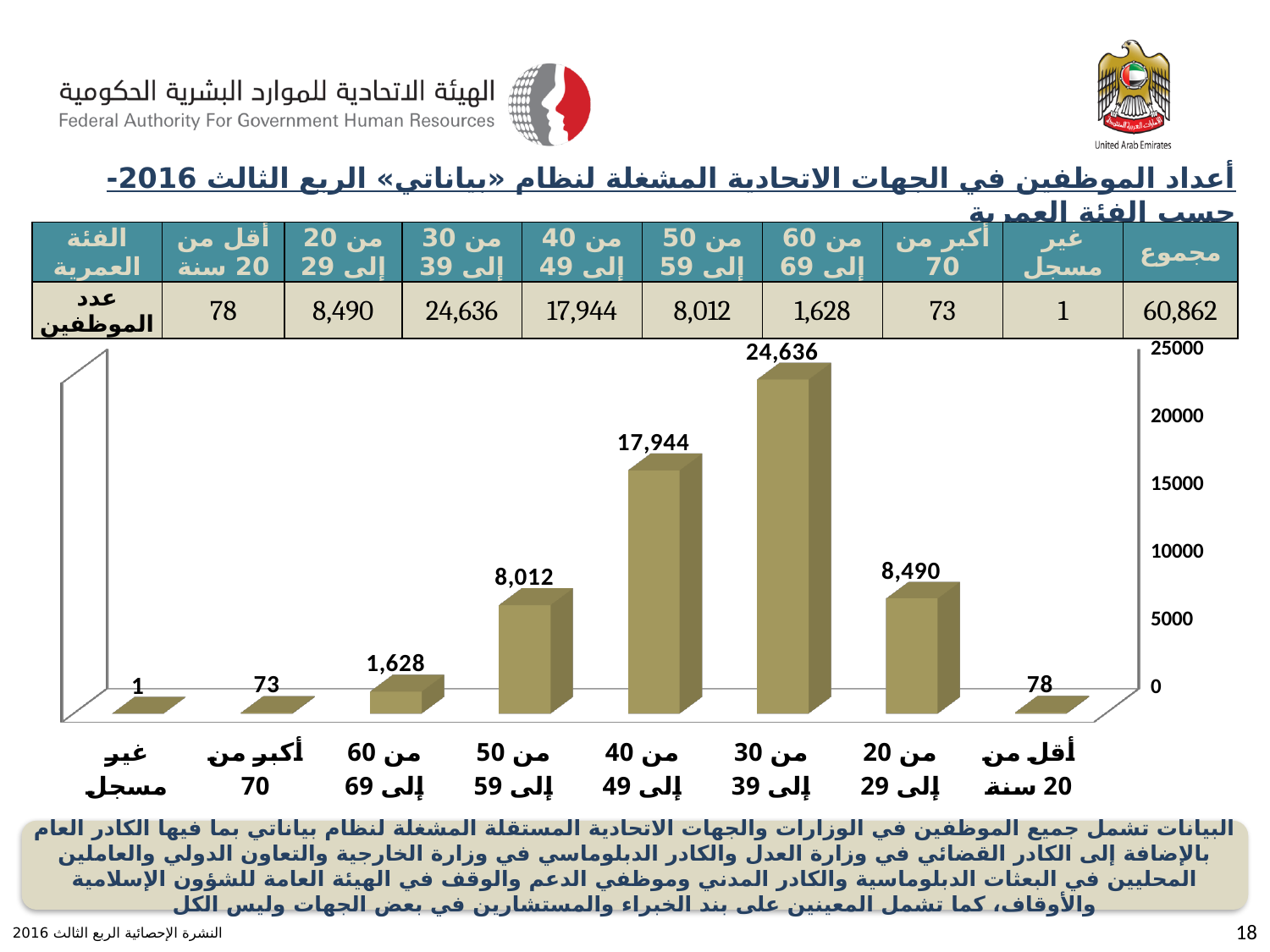
What is the number of employees in the category غير مسجل? 1 Which age group has the highest number of employees? من 30 إلى 39 What is the number of employees in the age group أكبر من 70? 73 Which has more employees: من 20 إلى 29 or من 50 إلى 59? من 20 إلى 29 Is the value for من 40 إلى 49 greater or less than 15000? greater What is the number of employees in the age group من 30 إلى 39? 24,636 Which category has the lowest number of employees? غير مسجل What is the number of employees in the age group من 40 إلى 49? 17,944 What is the total number of employees shown in the table (مجموع)? 60,862 What is the difference between the number of employees in من 30 إلى 39 and من 40 إلى 49? 6,692 How many age categories are shown on the chart? 8 What kind of chart is shown on the slide? Bar chart